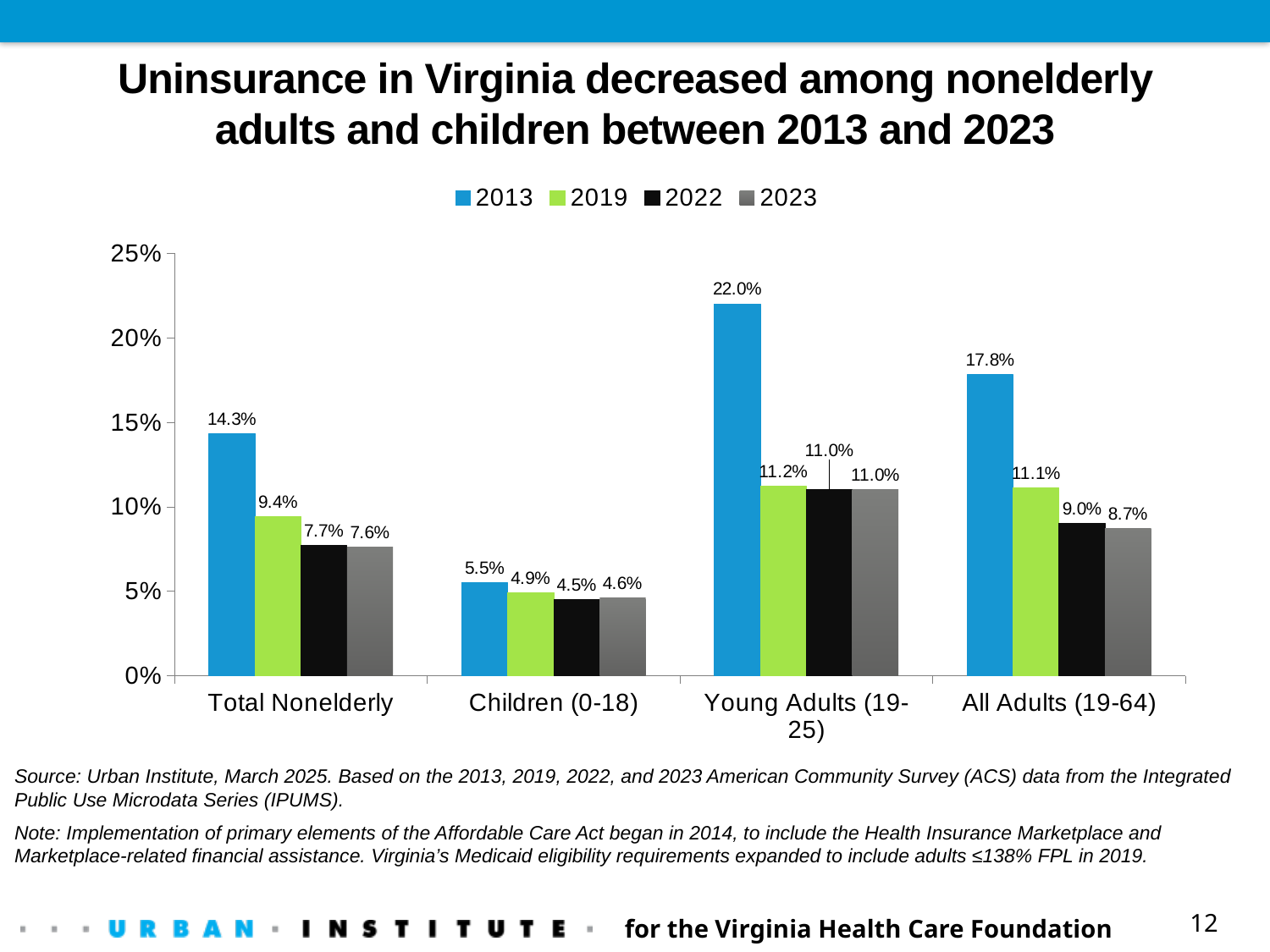
By how many percentage points did the uninsurance rate for All Adults (19-64) fall between 2013 and 2023? 9.1 percentage points What was the uninsurance rate for Total Nonelderly in 2019? 9.4% How many age categories are shown on the x axis? 4 Which category had the lowest uninsurance rate in 2022? Children (0-18) What type of chart is shown on the slide? Bar chart Which category had the highest uninsurance rate in 2013? Young Adults (19-25) What was the uninsurance rate for Children (0-18) in 2023? 4.6% Which colour represents 2013 in the chart? Blue Is the 2013 uninsurance rate for Total Nonelderly greater or less than 10%? greater How many years does the legend list? 4 Which was larger: the 2019 uninsurance rate for Young Adults (19-25) or for All Adults (19-64)? Young Adults (19-25) What was the uninsurance rate for Young Adults (19-25) in 2013? 22.0%